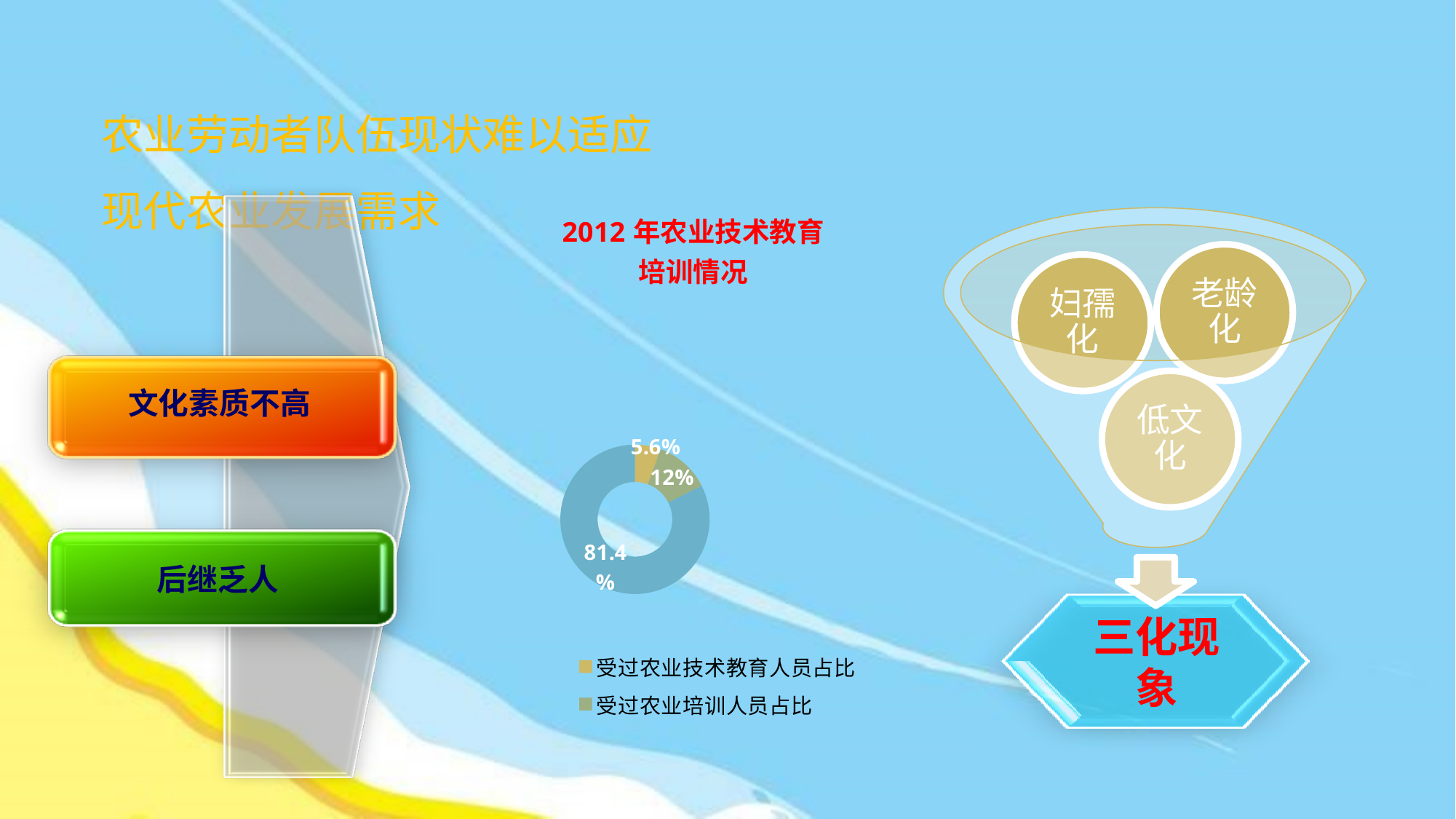
How many entries does the chart's legend list? 2 What is the first entry listed in the chart's legend? 受过农业技术教育人员占比 What is the difference between the 12% slice and the 5.6% slice? 6.4% What is the difference between the 81.4% slice and the 12% slice? 69.4% What kind of chart is shown under the title 2012 年农业技术教育培训情况? doughnut (pie) chart What is the largest value shown on the doughnut chart? 81.4% What is the value for 受过农业培训人员占比? 12% What is the smallest value shown on the doughnut chart? 5.6% What is the value for 受过农业技术教育人员占比? 5.6% How many slices does the doughnut chart have? 3 Which is larger, 受过农业培训人员占比 or 受过农业技术教育人员占比? 受过农业培训人员占比 What is the title of the chart on the slide? 2012 年农业技术教育培训情况